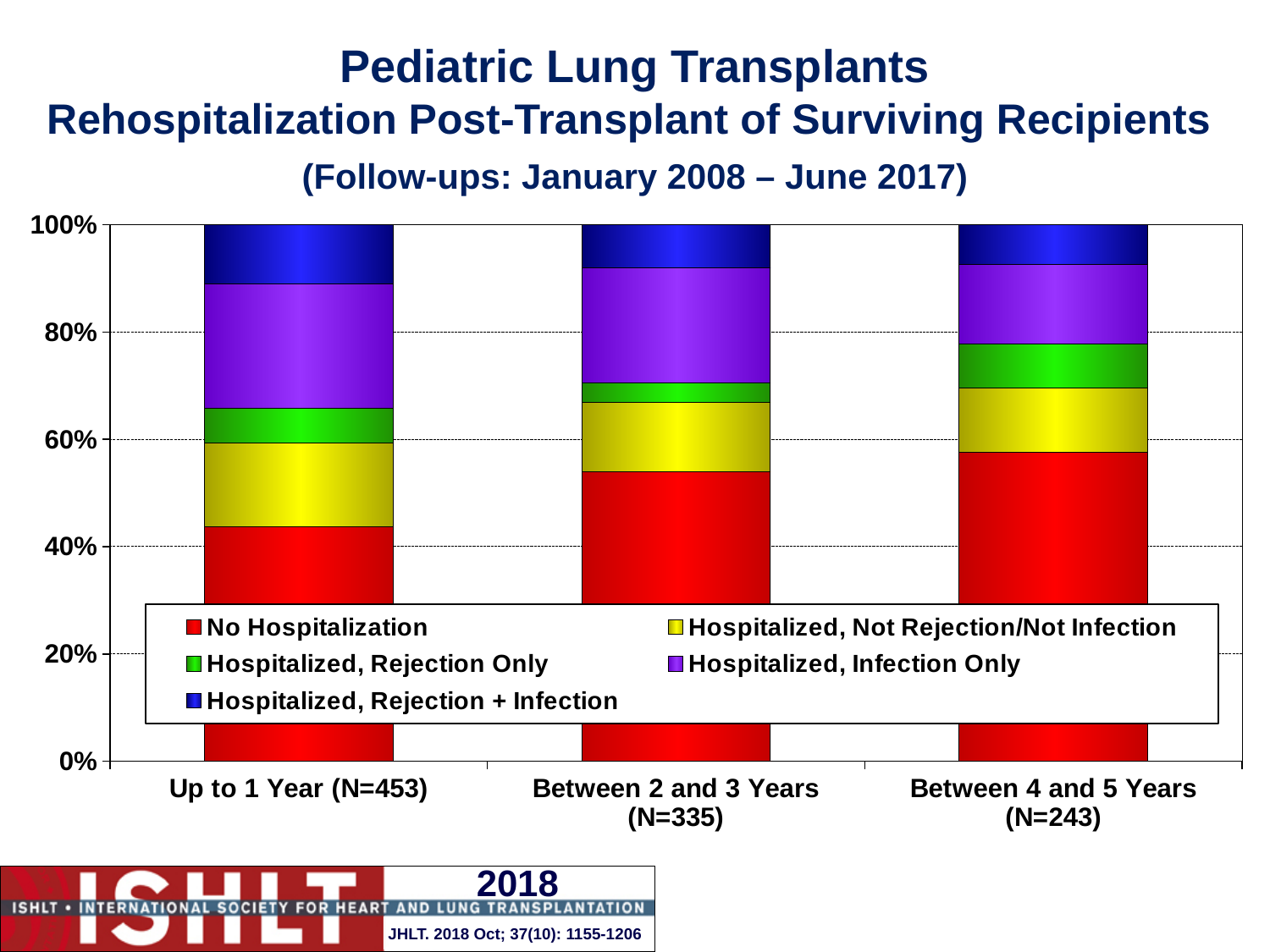
Which has the larger No Hospitalization share: Up to 1 Year (N=453) or Between 2 and 3 Years (N=335)? Between 2 and 3 Years (N=335) How many series does the legend list? 5 Which follow-up category has the smallest No Hospitalization share? Up to 1 Year (N=453) How many follow-up time categories are shown on the x axis? 3 Is the No Hospitalization share for Between 4 and 5 Years (N=243) greater or less than 40%? greater Which follow-up category has the smallest Hospitalized, Rejection Only share? Between 2 and 3 Years (N=335) Is the No Hospitalization share for Up to 1 Year (N=453) greater or less than 60%? less Which follow-up category has the largest Hospitalized, Rejection + Infection share? Up to 1 Year (N=453) Is the No Hospitalization share for Between 2 and 3 Years (N=335) greater or less than 60%? less What kind of chart is shown on the slide? Stacked bar chart Does the No Hospitalization share rise or fall from Up to 1 Year to Between 4 and 5 Years? rise